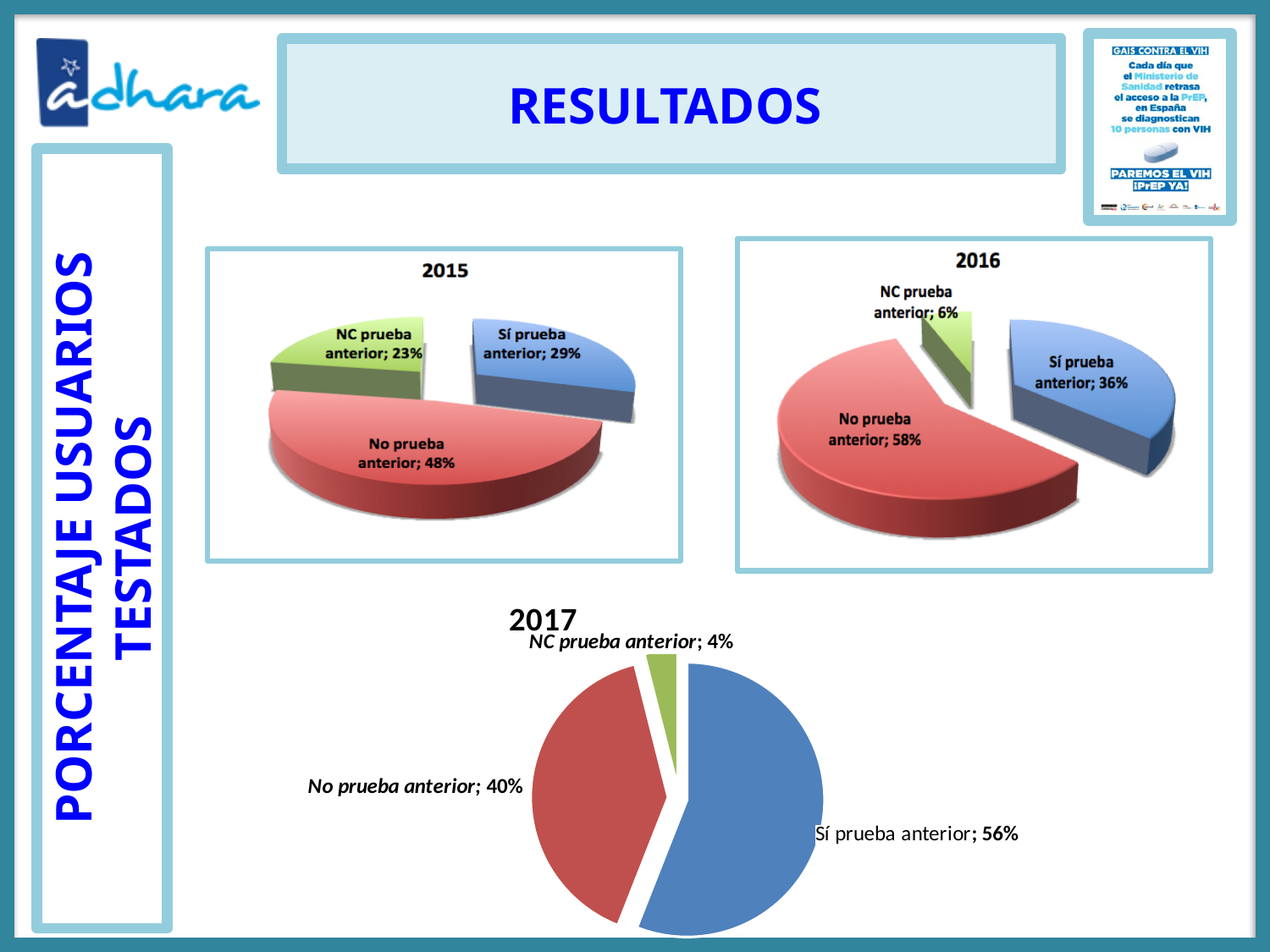
How many categories does the 2017 chart show? 3 In the 2017 chart, which category has the smallest share? NC prueba anterior What kind of chart is the 2016 chart? Pie chart In the 2016 chart, what is the difference between 'No prueba anterior' and 'Sí prueba anterior'? 22% In the 2016 chart, which category has the largest share? No prueba anterior In the 2017 chart, which is larger: 'Sí prueba anterior' or 'No prueba anterior'? Sí prueba anterior What is the title of the chart at the bottom of the slide? 2017 In the 2015 chart, what is the difference between 'No prueba anterior' and 'Sí prueba anterior'? 19% In the 2015 chart, what is the value for 'No prueba anterior'? 48% In the 2017 chart, what is the value for 'Sí prueba anterior'? 56% In the 2016 chart, what is the value for 'NC prueba anterior'? 6% In the 2015 chart, what is the value for 'Sí prueba anterior'? 29%